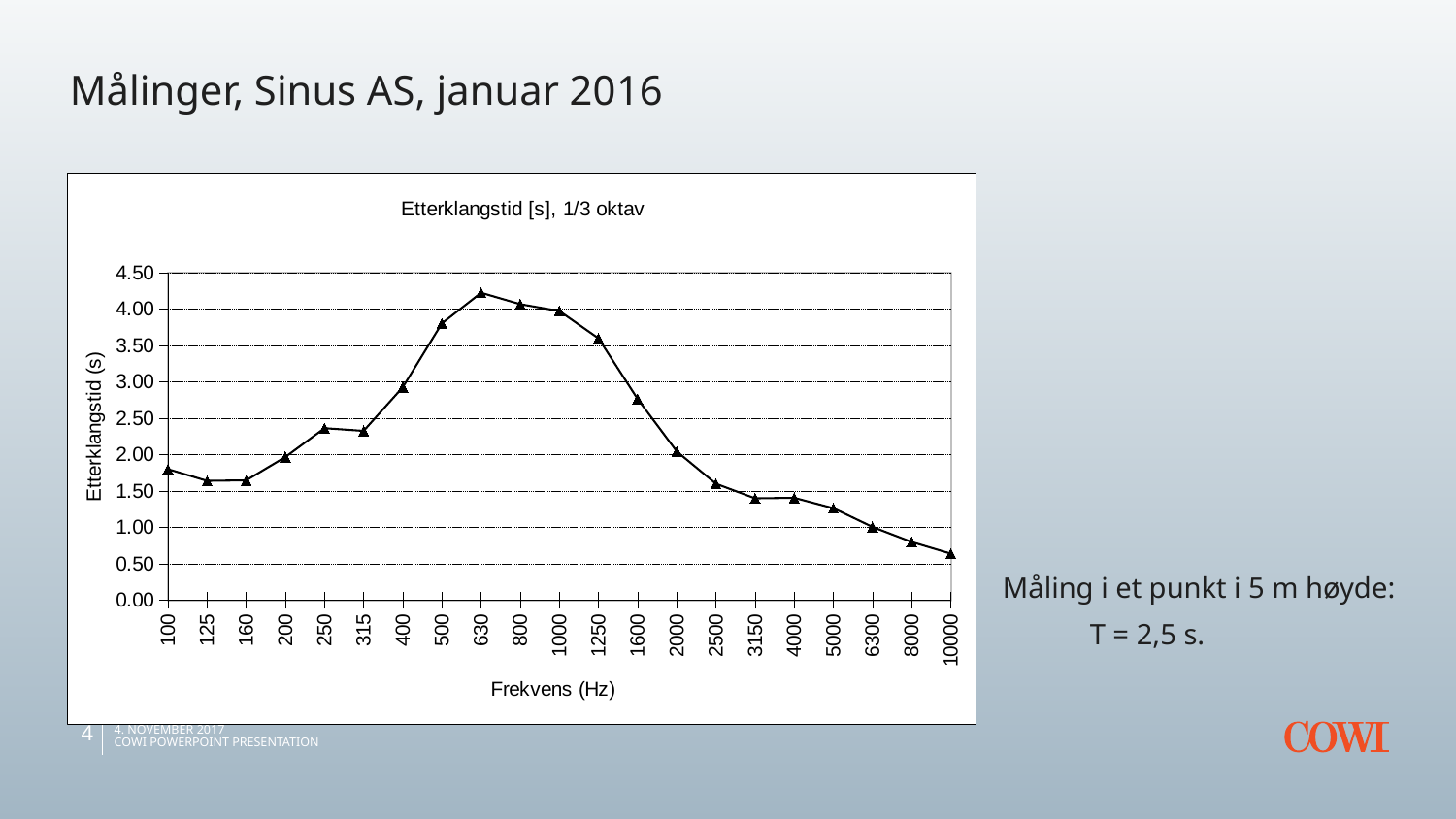
What kind of chart is shown on the slide? line chart Is the value for 8000 Hz greater or less than 1.00? less Which has the larger reverberation time, 100 Hz or 10000 Hz? 100 Hz How many frequency points are plotted on the chart? 21 Is the value for 500 Hz greater or less than 3.50? greater At which frequency is the reverberation time (Etterklangstid) highest? 630 What is the label of the x axis of the chart? Frekvens (Hz) Is the value for 100 Hz greater or less than 1.50? greater What is the title of the chart? Etterklangstid [s], 1/3 oktav At which frequency is the reverberation time (Etterklangstid) lowest? 10000 Do the values rise or fall along the x axis from 630 Hz to 10000 Hz? fall